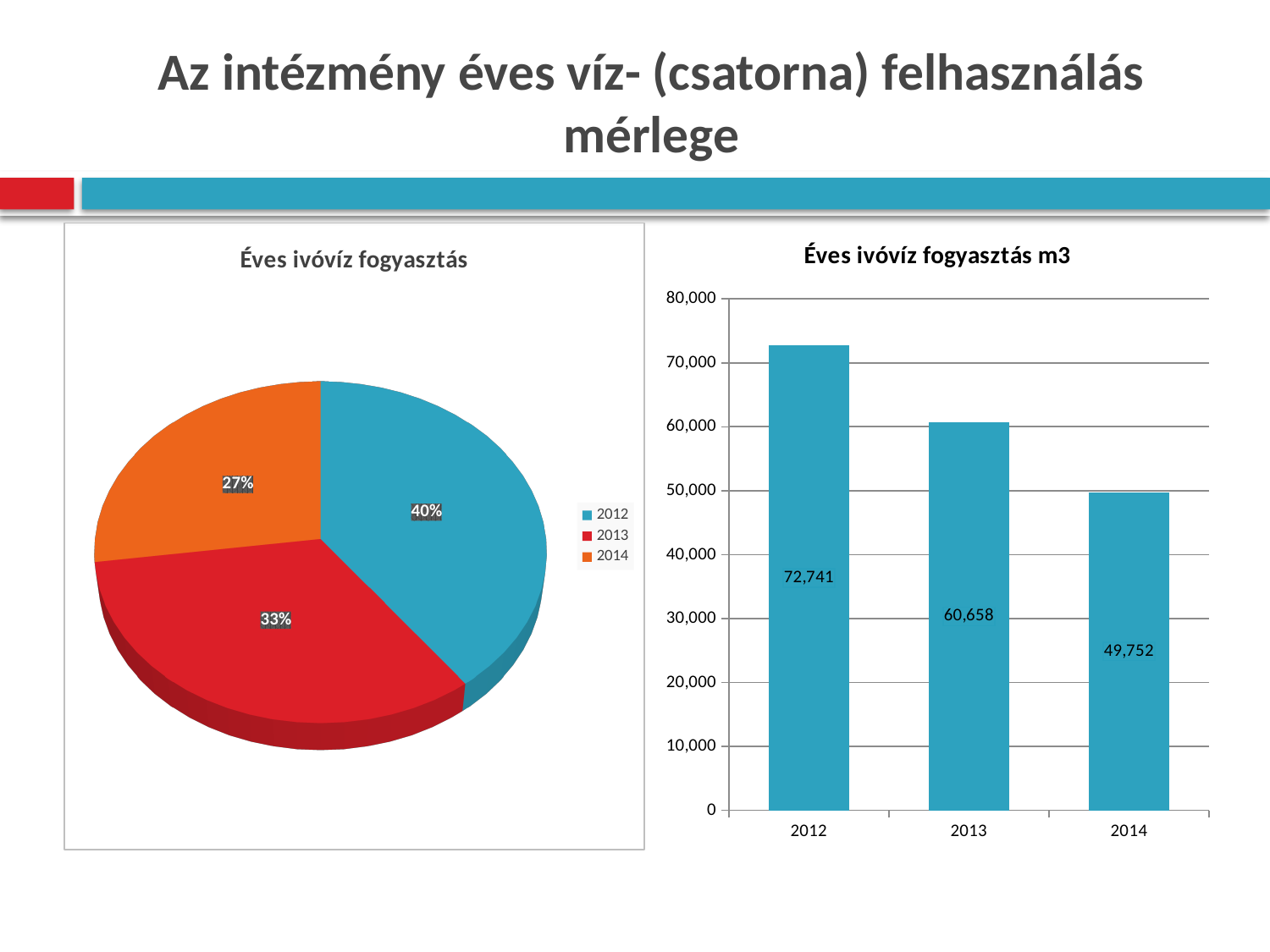
In the bar chart 'Éves ivóvíz fogyasztás m3', what is the difference between the values for 2012 and 2013? 12,083 In the bar chart 'Éves ivóvíz fogyasztás m3', what is the value for 2012? 72,741 In the bar chart 'Éves ivóvíz fogyasztás m3', which year has the lowest value? 2014 How many bars are in the bar chart 'Éves ivóvíz fogyasztás m3'? 3 In the pie chart 'Éves ivóvíz fogyasztás', which year has the smallest slice? 2014 In the bar chart 'Éves ivóvíz fogyasztás m3', is the value for 2013 greater or less than 60,000? greater In the bar chart 'Éves ivóvíz fogyasztás m3', which year has the highest value? 2012 In the pie chart 'Éves ivóvíz fogyasztás', what share does 2013 have? 33% How many entries does the legend of the pie chart 'Éves ivóvíz fogyasztás' list? 3 In the bar chart 'Éves ivóvíz fogyasztás m3', what is the value for 2014? 49,752 In the bar chart 'Éves ivóvíz fogyasztás m3', do the values rise or fall from 2012 to 2014? fall What kind of chart is the chart on the left of the slide? pie chart